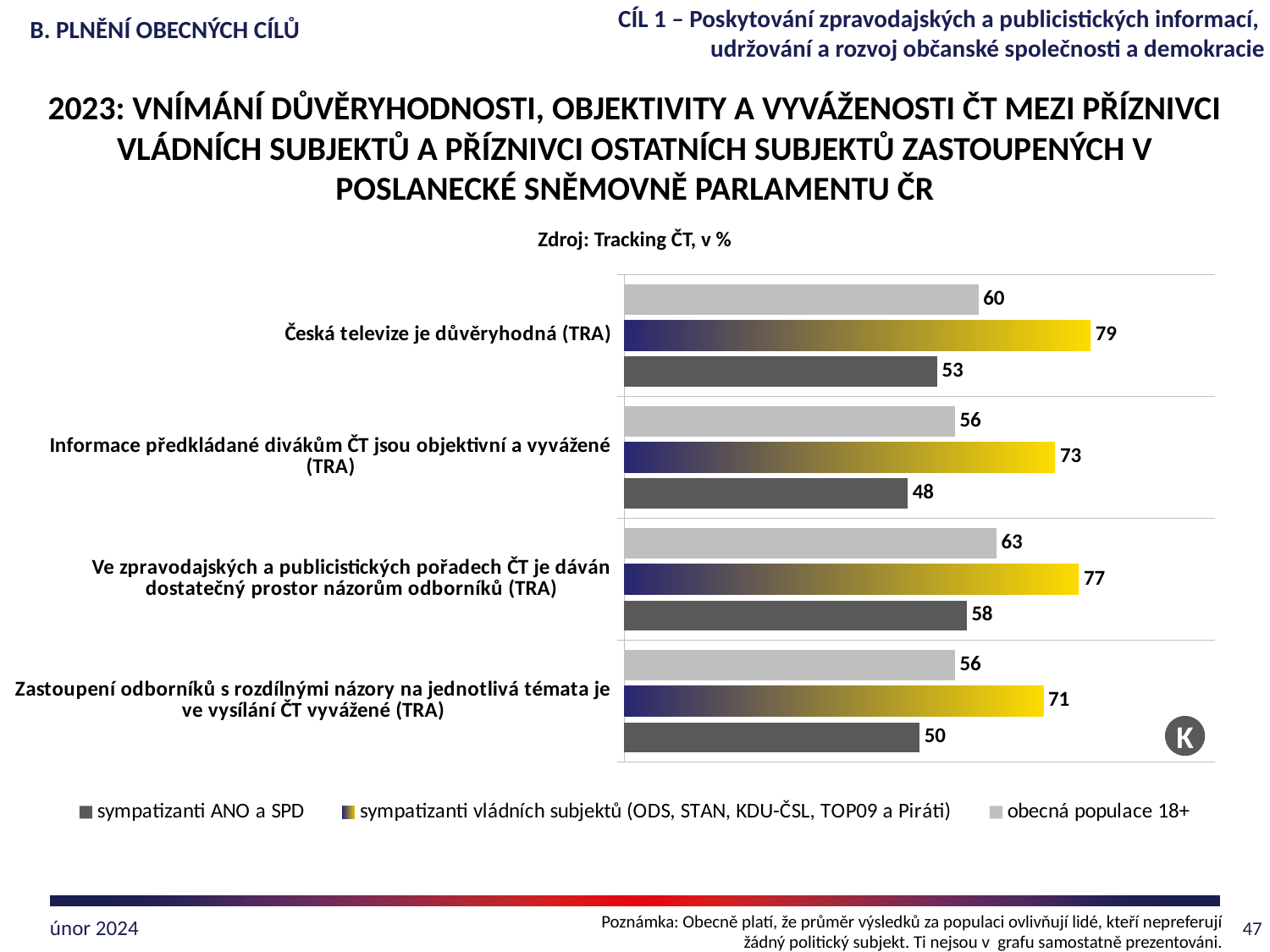
What is the value for 'sympatizanti ANO a SPD' on the statement 'Zastoupení odborníků s rozdílnými názory na jednotlivá témata je ve vysílání ČT vyvážené (TRA)'? 50 What is the difference between 'obecná populace 18+' and 'sympatizanti ANO a SPD' on the statement 'Zastoupení odborníků s rozdílnými názory na jednotlivá témata je ve vysílání ČT vyvážené (TRA)'? 6 What is the value for 'sympatizanti vládních subjektů (ODS, STAN, KDU-ČSL, TOP09 a Piráti)' on the statement 'Česká televize je důvěryhodná (TRA)'? 79 Which statement has the lowest value for 'sympatizanti ANO a SPD'? Informace předkládané divákům ČT jsou objektivní a vyvážené (TRA) How many statements (categories) are shown in the chart? 4 Which is larger: the 'obecná populace 18+' value for 'Česká televize je důvěryhodná (TRA)' or for 'Informace předkládané divákům ČT jsou objektivní a vyvážené (TRA)'? Česká televize je důvěryhodná (TRA) What is the value for 'obecná populace 18+' on the statement 'Ve zpravodajských a publicistických pořadech ČT je dáván dostatečný prostor názorům odborníků (TRA)'? 63 How many series does the legend list? 3 Which statement has the highest value for 'sympatizanti vládních subjektů (ODS, STAN, KDU-ČSL, TOP09 a Piráti)'? Česká televize je důvěryhodná (TRA) What kind of chart is shown on the slide? Bar chart What is the difference between 'sympatizanti vládních subjektů' and 'sympatizanti ANO a SPD' on the statement 'Česká televize je důvěryhodná (TRA)'? 26 What is the value for 'sympatizanti ANO a SPD' on the statement 'Informace předkládané divákům ČT jsou objektivní a vyvážené (TRA)'? 48